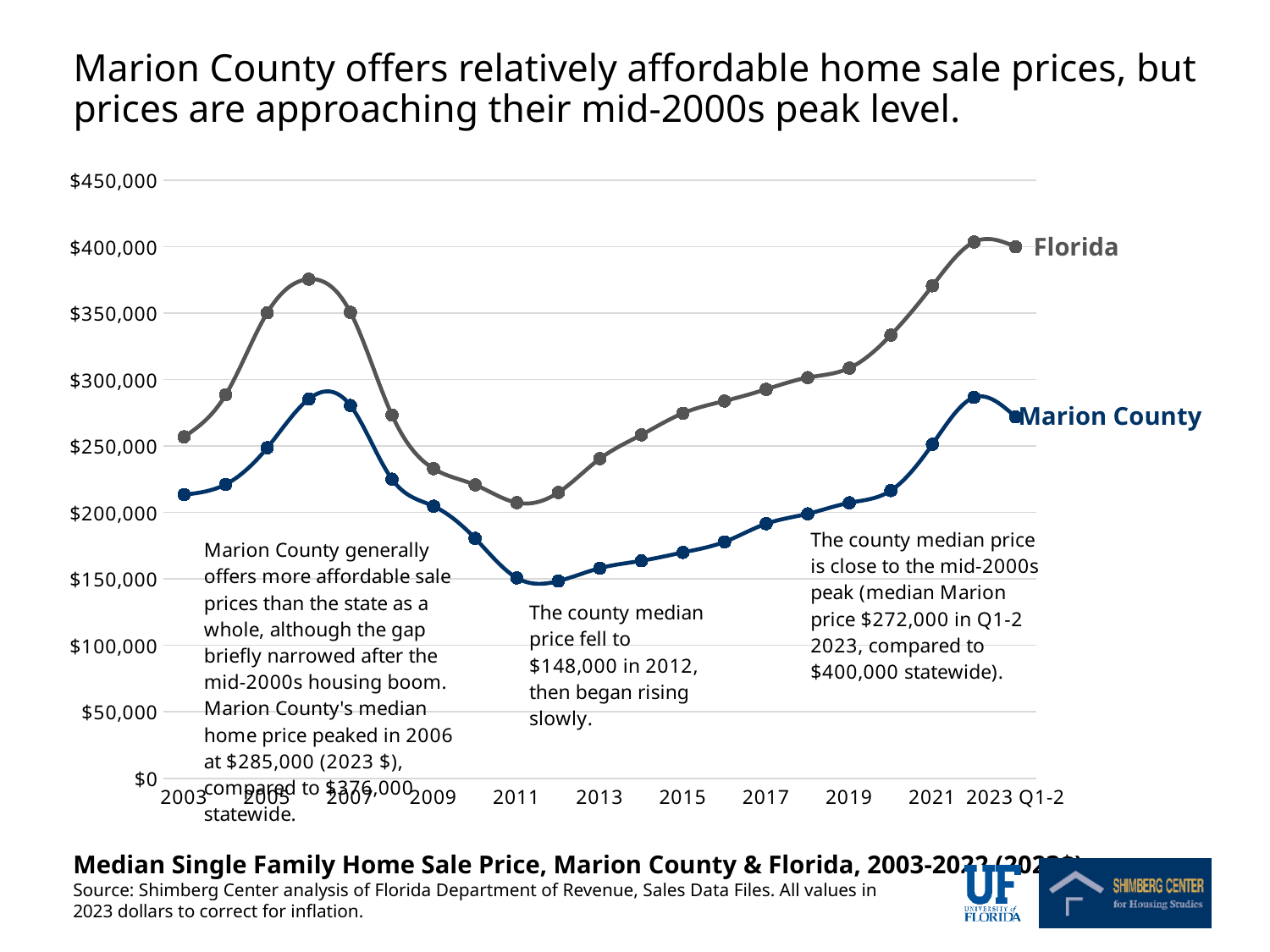
Is the value for Florida in 2009 greater or less than $250,000? less What type of chart is shown on the slide? line chart According to the slide, what was the median Marion County price in Q1-2 2023? $272,000 Is the value for Marion County in 2010 greater or less than $200,000? less How many series are plotted on the chart? 2 According to the slide, what was the statewide median home price in 2006? $376,000 What is the difference between the 2006 statewide peak and the 2006 Marion County peak, as stated on the slide? $91,000 Does the Marion County line rise or fall between 2012 and 2022? rise According to the slide, what did the Marion County median price fall to in 2012? $148,000 According to the slide, what was Marion County's median home price at its 2006 peak? $285,000 Which series has the higher value in 2006, Florida or Marion County? Florida What is the difference between the statewide and Marion County median prices in Q1-2 2023, as stated on the slide? $128,000